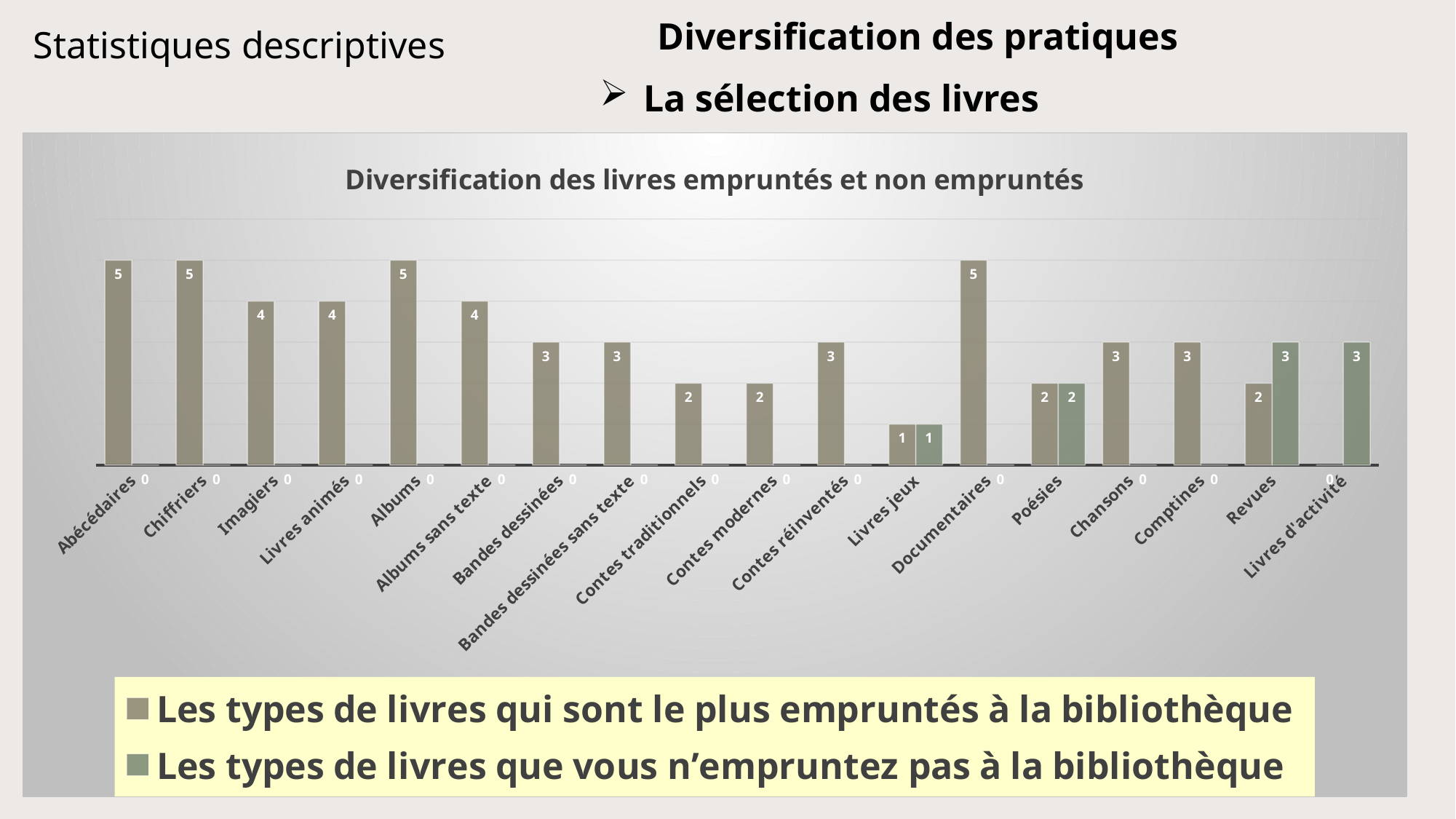
How many categories are shown on the x axis of the chart? 18 What is the value for Documentaires in the series 'Les types de livres qui sont le plus empruntés à la bibliothèque'? 5 What is the value for Imagiers in the series 'Les types de livres qui sont le plus empruntés à la bibliothèque'? 4 What kind of chart is shown on the slide? Bar chart How many series does the legend list? 2 In the series 'Les types de livres qui sont le plus empruntés à la bibliothèque', what is the difference between the values for Albums and Contes traditionnels? 3 What is the title of the chart? Diversification des livres empruntés et non empruntés For Revues, which series has the larger value: 'le plus empruntés' or 'n'empruntez pas'? Les types de livres que vous n'empruntez pas à la bibliothèque Which category has the lowest value in the series 'Les types de livres qui sont le plus empruntés à la bibliothèque'? Livres d'activité What is the value for Revues in the series 'Les types de livres que vous n'empruntez pas à la bibliothèque'? 3 What is the value for Livres jeux in the series 'Les types de livres qui sont le plus empruntés à la bibliothèque'? 1 What is the value for Poésies in the series 'Les types de livres que vous n'empruntez pas à la bibliothèque'? 2